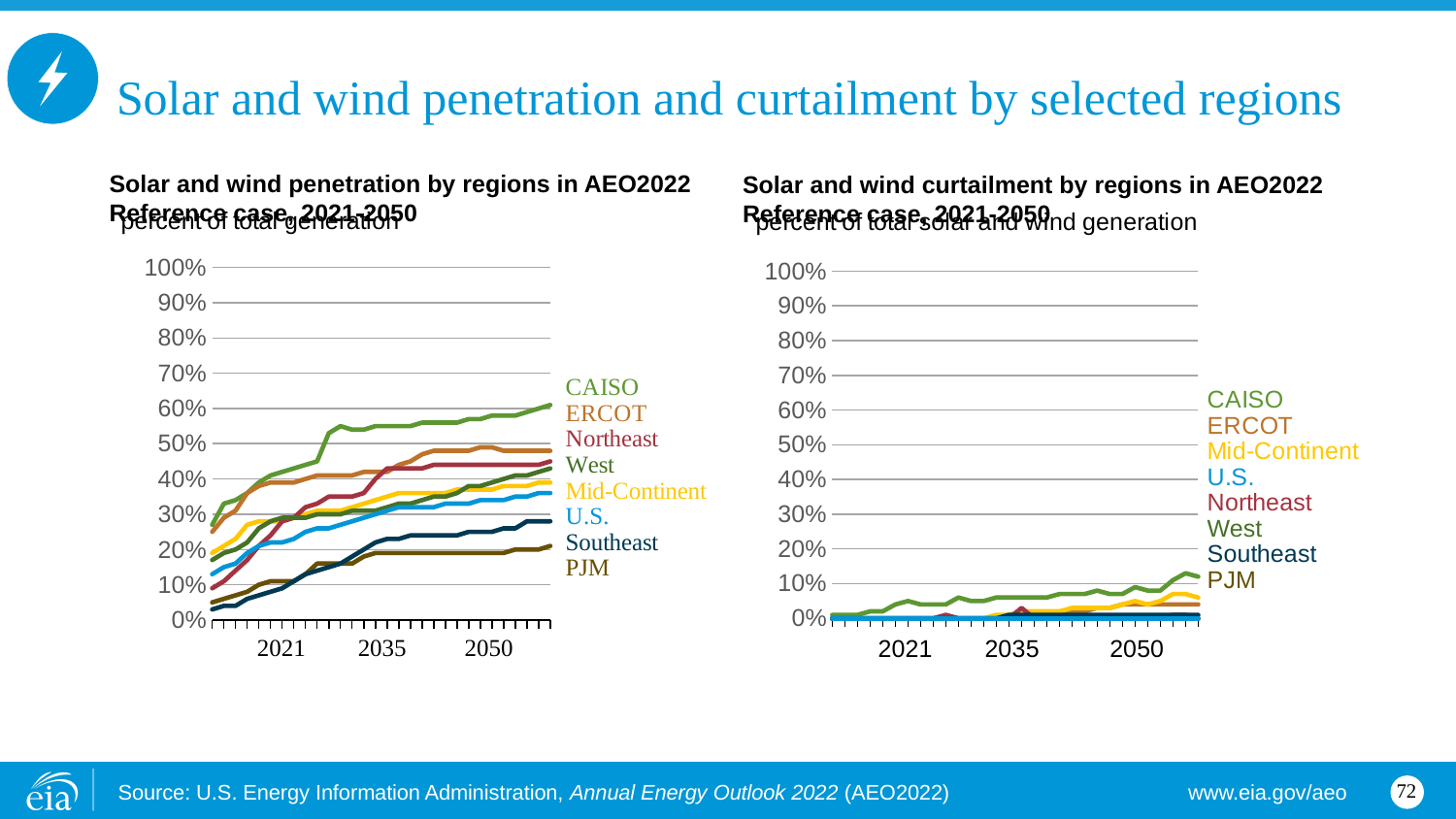
What kind of chart is the 'Solar and wind curtailment by regions' chart on the right? Line chart In the left chart (solar and wind penetration), which region has the highest value in 2050? CAISO In the left chart (solar and wind penetration), is the value for CAISO in 2050 greater or less than 50%? greater What unit is shown on the y axis of the right chart (solar and wind curtailment)? percent of total solar and wind generation In the left chart (solar and wind penetration), is the value for PJM in 2050 greater or less than 30%? less What kind of chart is the 'Solar and wind penetration by regions' chart on the left? Line chart In the right chart (solar and wind curtailment), which region has the highest value in 2050? CAISO How many series does the legend of the right chart (solar and wind curtailment) list? 8 How many series does the legend of the left chart (solar and wind penetration) list? 8 In the left chart (solar and wind penetration), does the CAISO line rise or fall from 2021 to 2050? Rise In the left chart (solar and wind penetration), which region has the lowest value in 2050? PJM In the right chart (solar and wind curtailment), is the value for CAISO in 2050 greater or less than 10%? greater